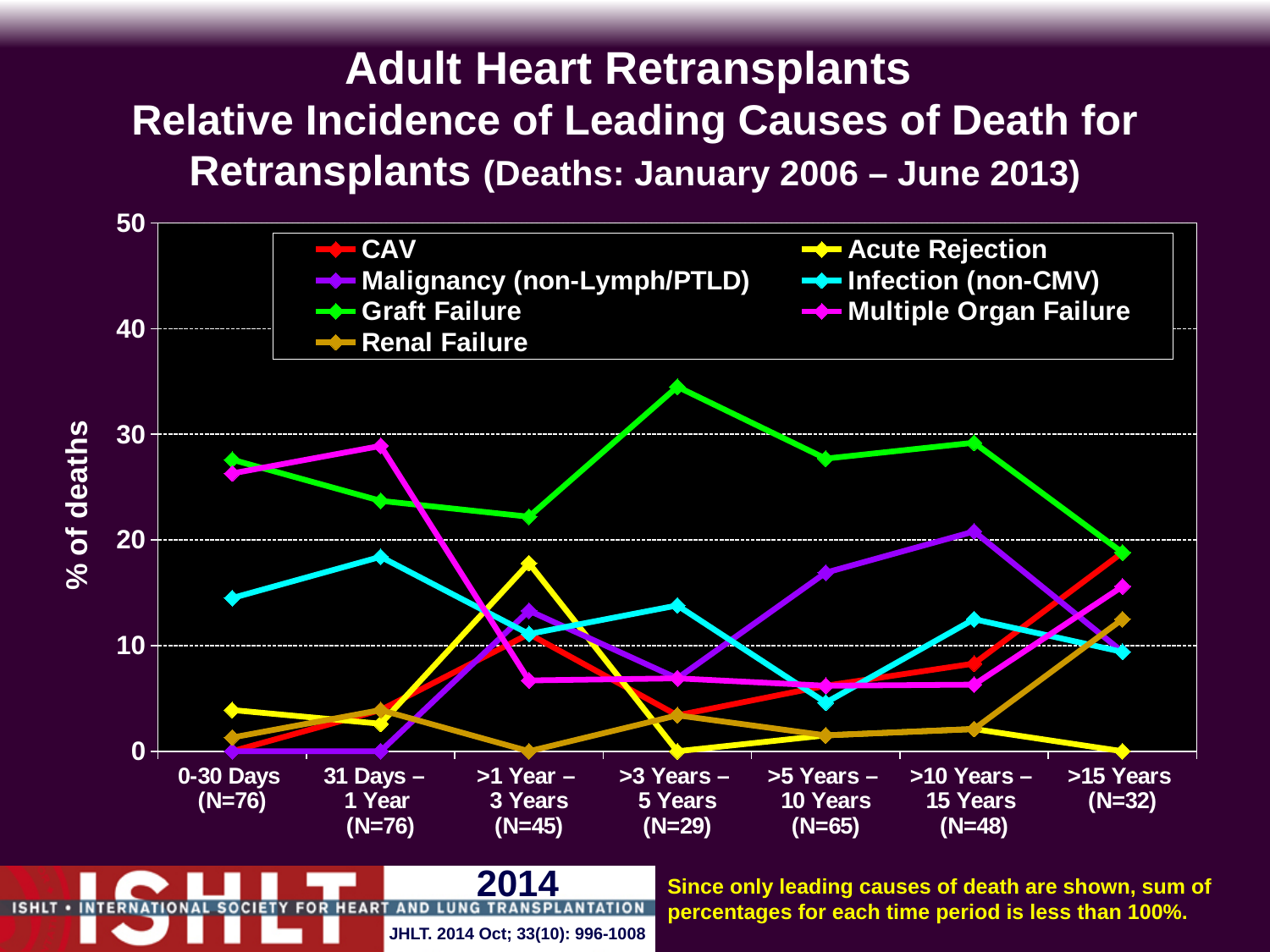
What is the label on the y axis? % of deaths What is the value for CAV at 0-30 Days? 0 What type of chart is shown on the slide? Line chart Is the value for Graft Failure at >3 Years – 5 Years greater or less than 30? greater Is the value for Acute Rejection at >1 Year – 3 Years greater or less than 20? less Which cause of death has the highest value at >3 Years – 5 Years? Graft Failure At >15 Years, which is larger: CAV or Infection (non-CMV)? CAV How many time periods are shown along the x axis? 7 In which time period does Graft Failure reach its highest value? >3 Years – 5 Years Does the Acute Rejection line rise or fall from >1 Year – 3 Years to >3 Years – 5 Years? Fall What is the value for Malignancy (non-Lymph/PTLD) at 0-30 Days? 0 How many series does the legend list? 7